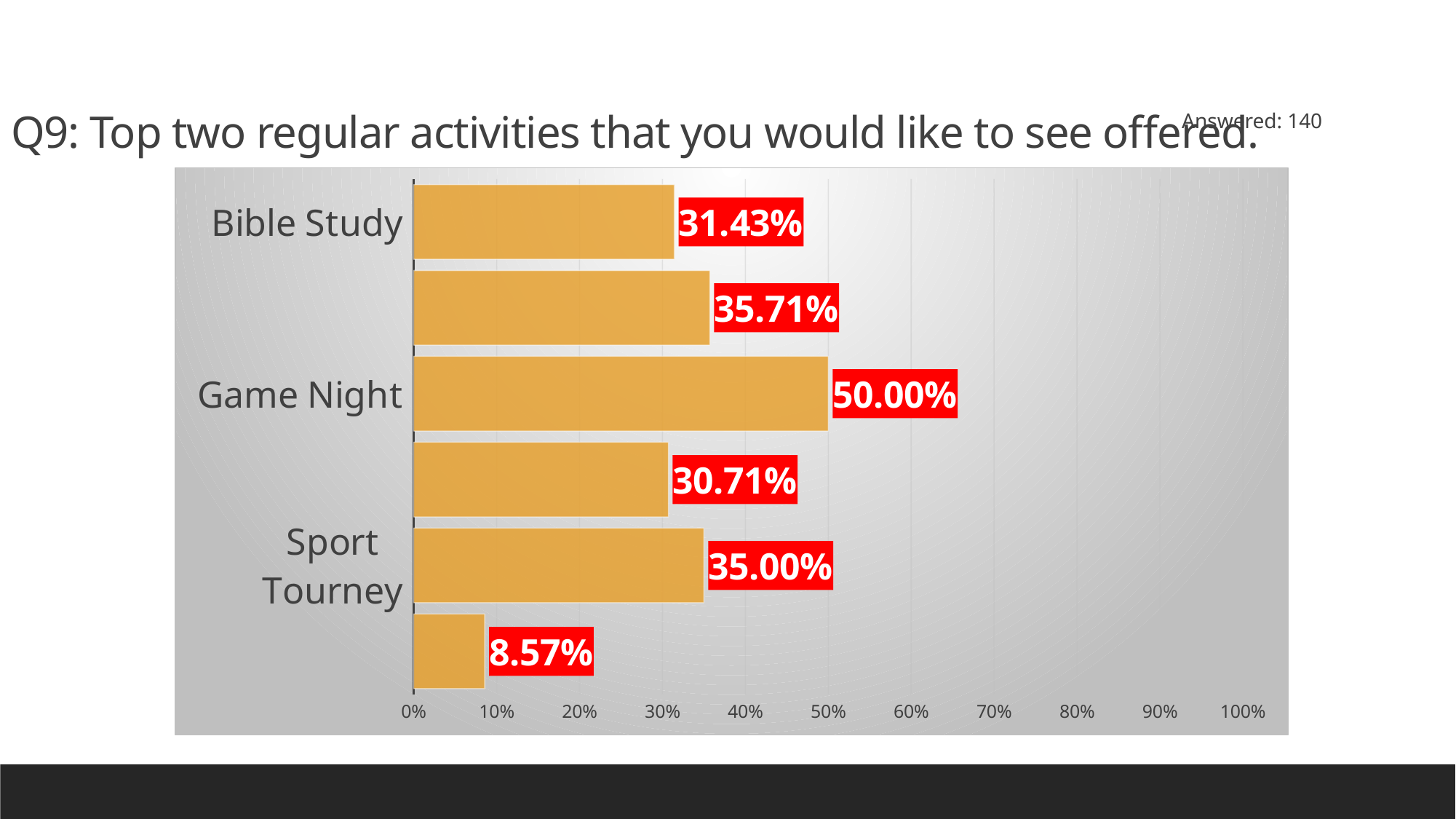
What is the value for Game Night? 50.00% How many bars are plotted on the chart? 6 Which is larger, the value for Sport Tourney or the value for Bible Study? Sport Tourney How many respondents answered the question, according to the slide? 140 What is the difference between the values for Game Night and Bible Study? 18.57% What kind of chart is shown on the slide? bar chart What is the difference between the values for Game Night and Sport Tourney? 15.00% What is the value for Bible Study? 31.43% What is the smallest value shown on the chart? 8.57% Which labelled category has the highest value? Game Night What is the value for Sport Tourney? 35.00% Is the value for Bible Study greater or less than 40%? less